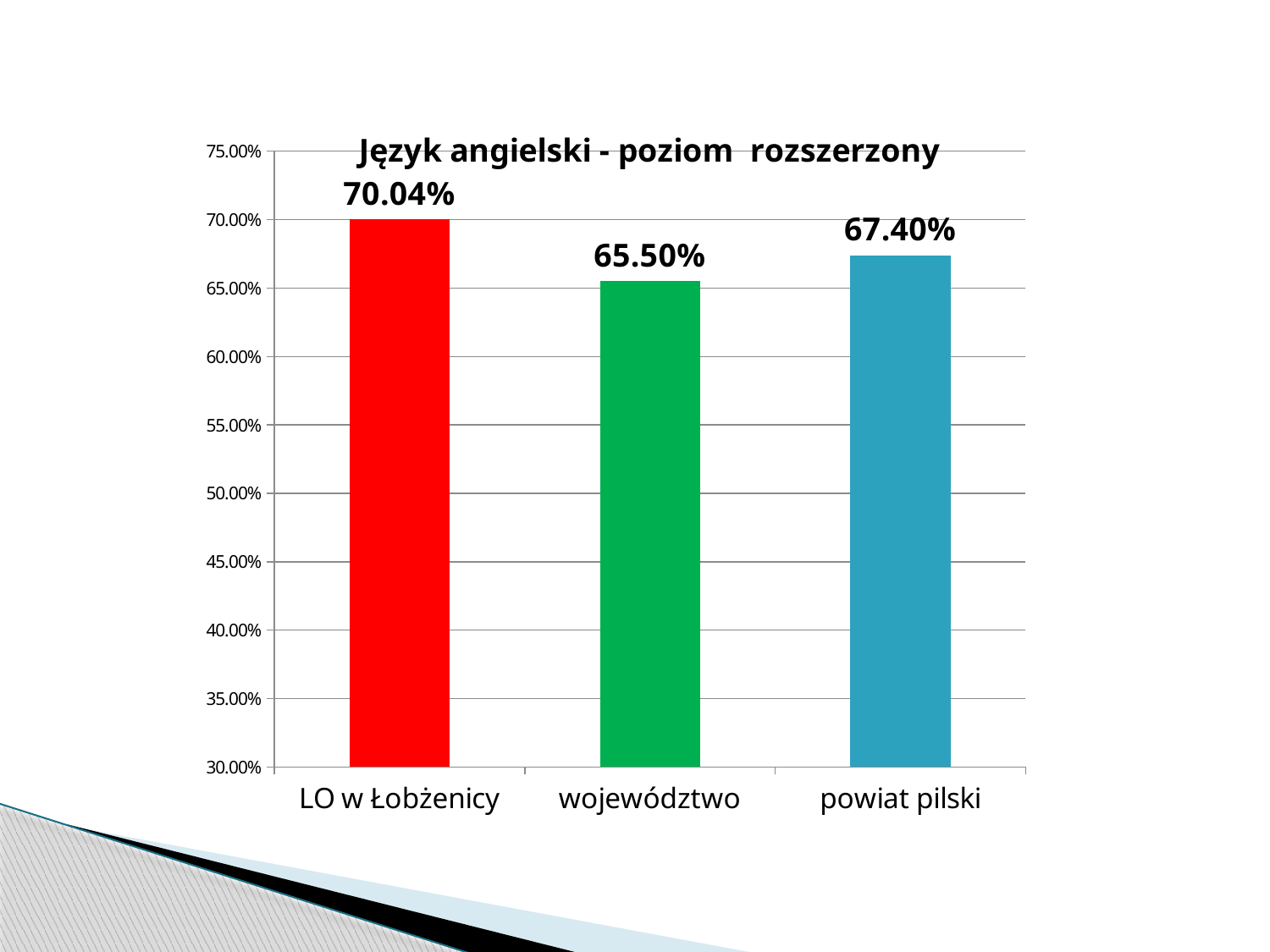
How many categories are shown on the chart? 3 What is the title of the chart? Język angielski - poziom rozszerzony Which is larger, the value for powiat pilski or the value for województwo? powiat pilski What is the value for LO w Łobżenicy? 70.04% What is the difference between the values for powiat pilski and województwo? 1.90% What is the value for województwo? 65.50% What kind of chart is shown on the slide? bar chart What is the difference between the values for LO w Łobżenicy and województwo? 4.54% Which category has the lowest value? województwo Is the value for powiat pilski greater or less than 70.00%? less Which category has the highest value? LO w Łobżenicy What is the value for powiat pilski? 67.40%